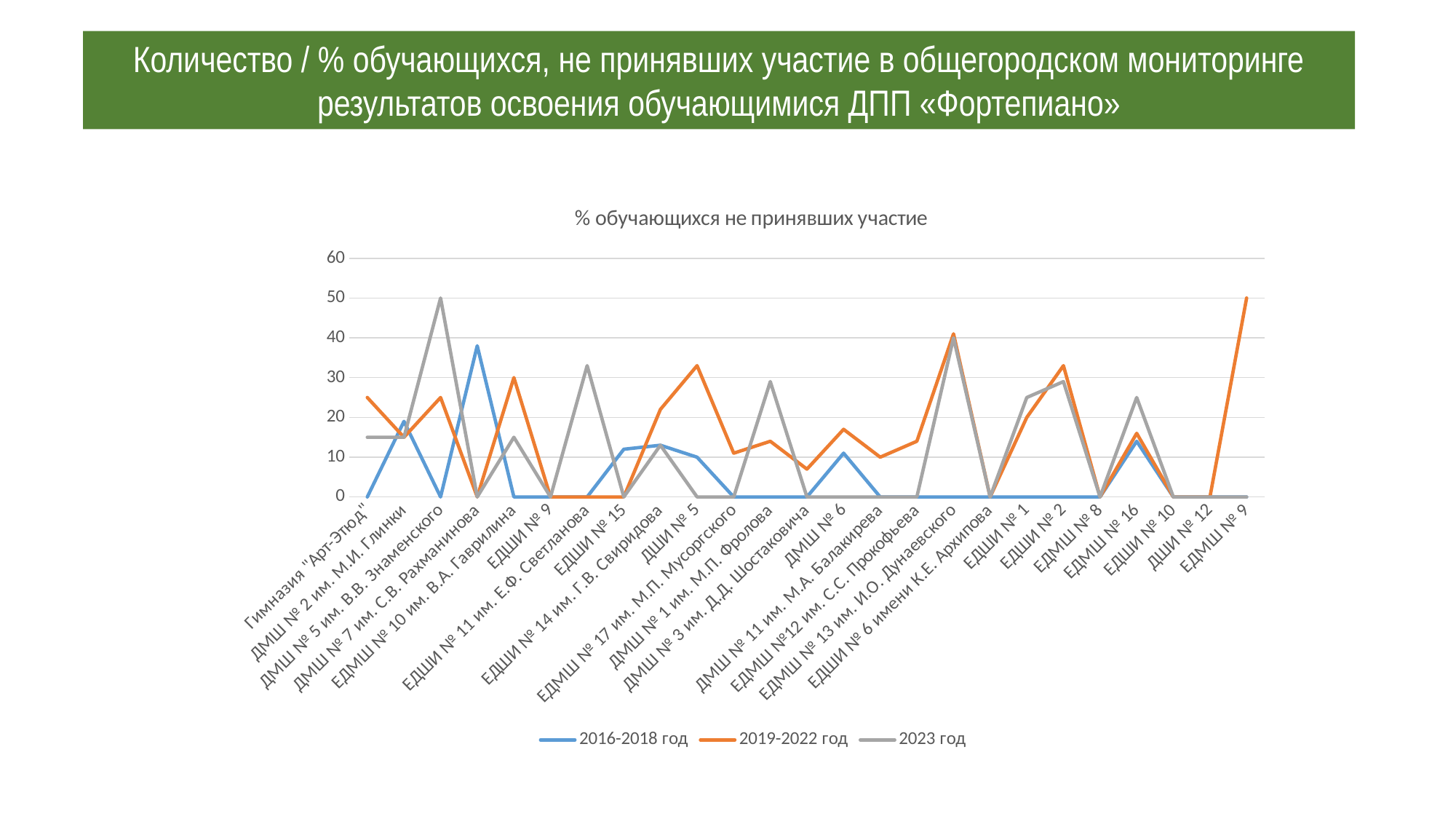
What is the title of the chart? % обучающихся не принявших участие How many series does the legend list? 3 Which school has the highest 2023 год value? ДМШ № 5 им. В.В. Знаменского Which school has the highest 2016-2018 год value? ДМШ № 7 им. С.В. Рахманинова What is the 2023 год value for ДМШ № 5 им. В.В. Знаменского? 50 What kind of chart is shown on the slide? line chart How many schools (categories) are plotted along the x axis? 25 What is the 2019-2022 год value for ЕДМШ № 9? 50 What is the 2016-2018 год value for ЕДШИ № 9? 0 For ДМШ № 5 им. В.В. Знаменского, which series has the larger value: 2019-2022 год or 2023 год? 2023 год Is the 2016-2018 год value for ДМШ № 7 им. С.В. Рахманинова greater or less than 30? greater